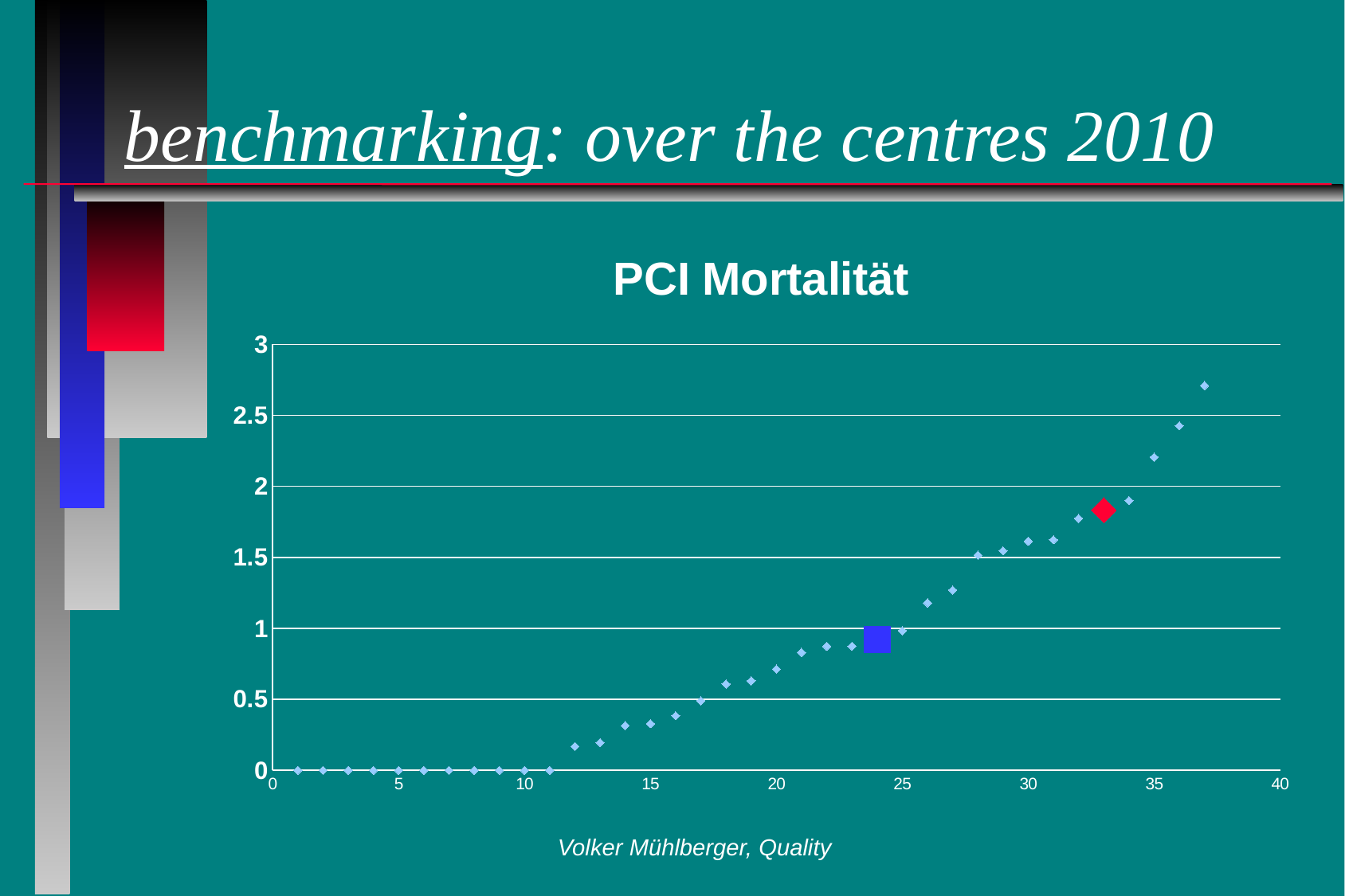
Do the plotted values rise or fall as the x axis increases from 0 to 40? rise What kind of chart is shown on the slide? scatter chart Is the value of the point at x = 20 greater or less than 1? less What is the value of the point at x = 5? 0 Is the value of the blue square marker greater or less than 1? less Is the value of the point at x = 37 greater or less than 2.5? greater What is the title of the chart? PCI Mortalität Which has the larger value, the point at x = 35 or the point at x = 15? x = 35 At which x position is the highest plotted point? 37